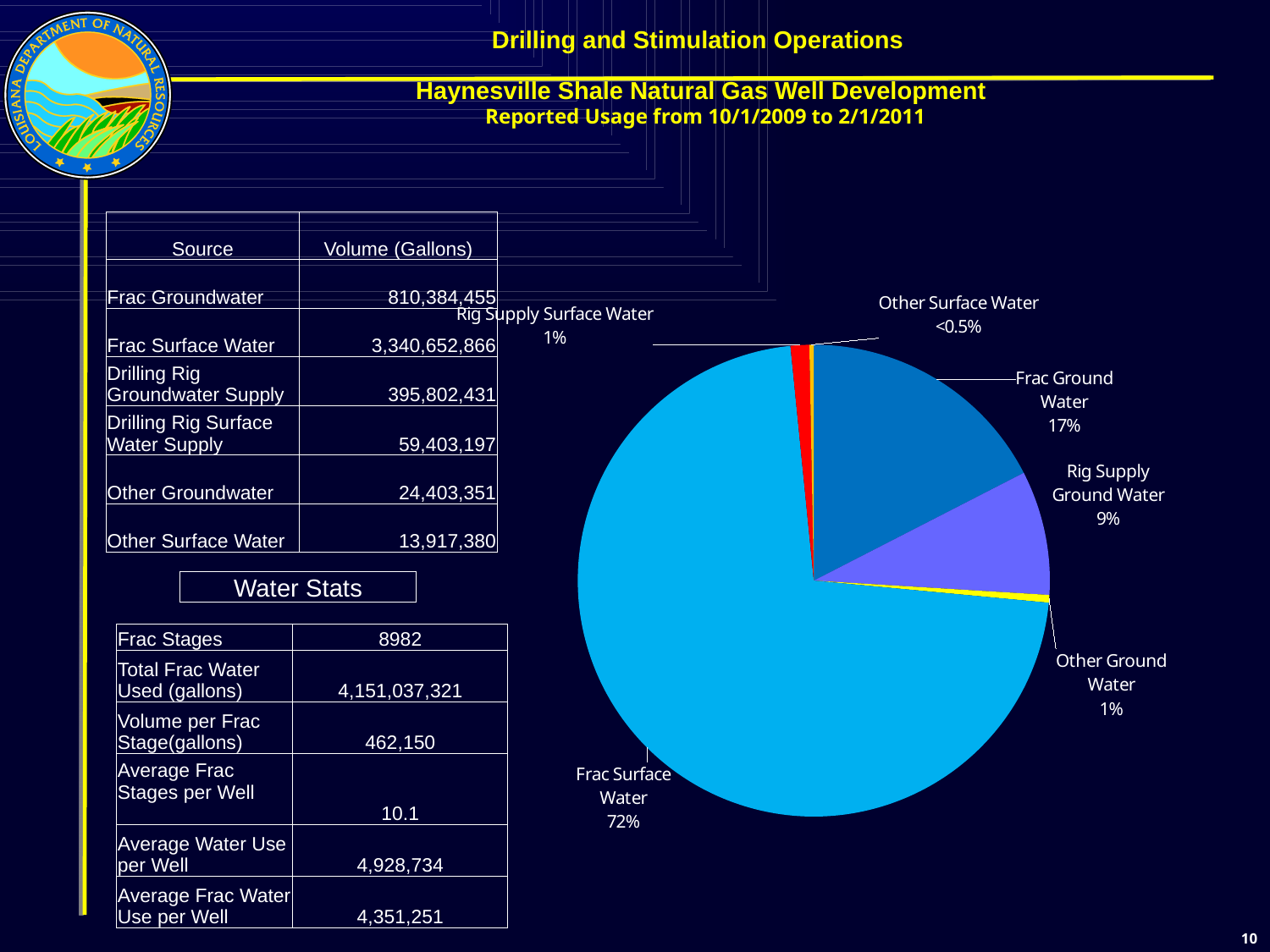
How many slices does the pie chart have? 6 What is the difference in percentage points between Frac Surface Water and Frac Ground Water in the pie chart? 55 Which slice of the pie chart is the largest? Frac Surface Water What percentage label is shown for Other Surface Water in the pie chart? <0.5% What percentage is shown for Rig Supply Ground Water in the pie chart? 9% What percentage is shown for Frac Ground Water in the pie chart? 17% What is the subtitle shown below the chart title on the slide? Reported Usage from 10/1/2009 to 2/1/2011 What kind of chart is shown on the slide? pie chart What percentage is shown for Rig Supply Surface Water in the pie chart? 1% Which is larger in the pie chart, Frac Ground Water or Rig Supply Ground Water? Frac Ground Water What share of the pie does Frac Surface Water represent? 72% Which slice of the pie chart is the smallest? Other Surface Water